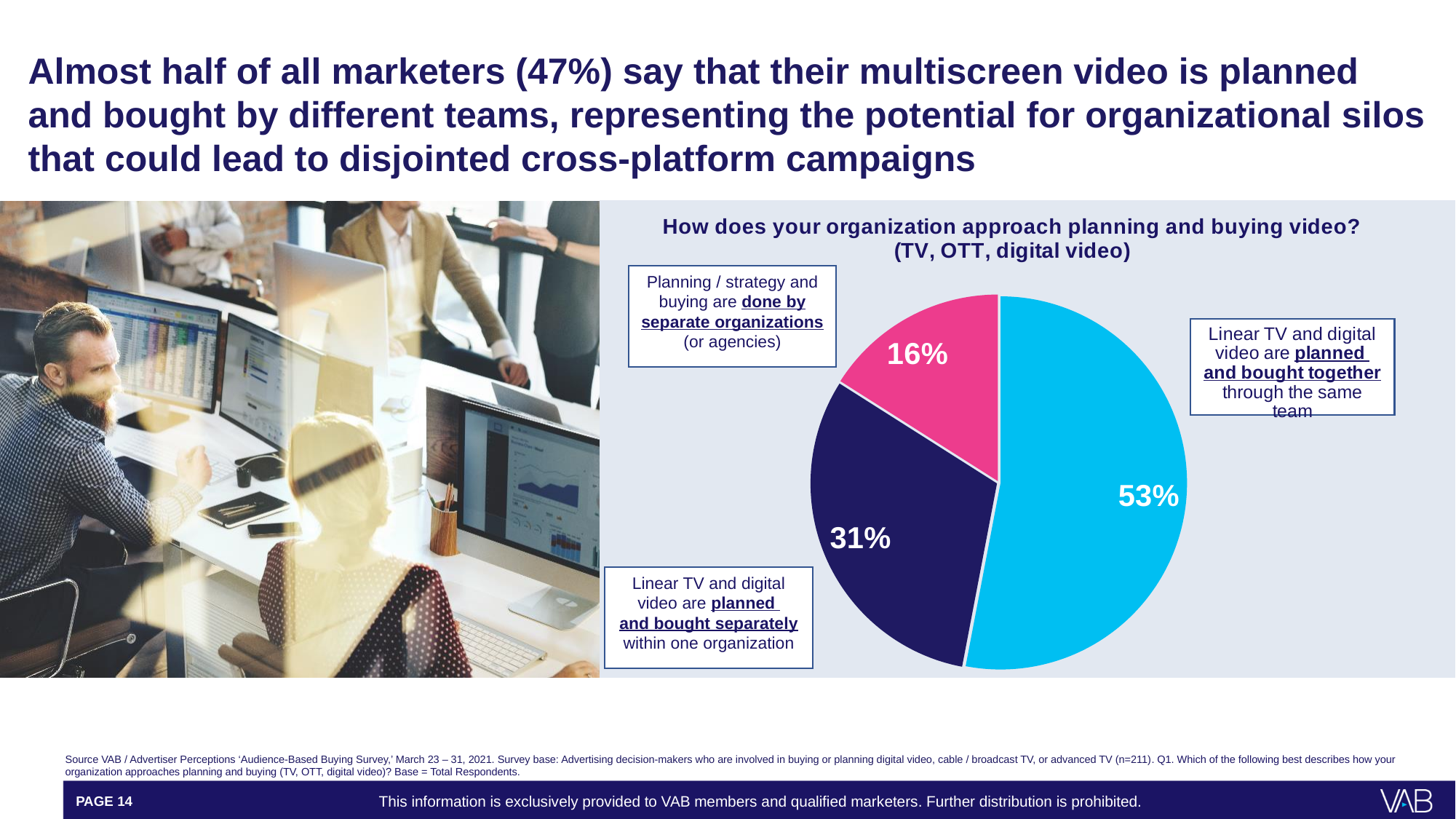
Which response has the largest slice of the pie? Planned and bought together through the same team What is the combined share of the two responses where planning and buying are done by different teams (separately within one organization, or by separate organizations)? 47% What share of respondents say linear TV and digital video are planned and bought together through the same team? 53% What share of respondents say planning / strategy and buying are done by separate organizations (or agencies)? 16% What share of respondents say linear TV and digital video are planned and bought separately within one organization? 31% What colour is the slice representing 'planned and bought together through the same team'? Light blue Which is larger: the share for 'planned and bought separately within one organization' or the share for 'done by separate organizations (or agencies)'? Planned and bought separately within one organization What is the title of the pie chart? How does your organization approach planning and buying video? (TV, OTT, digital video) How many slices does the pie chart have? 3 What kind of chart is shown on the slide? Pie chart What is the difference in percentage points between the 'planned and bought together' slice and the 'planned and bought separately within one organization' slice? 22 percentage points Which response has the smallest slice of the pie? Done by separate organizations (or agencies)